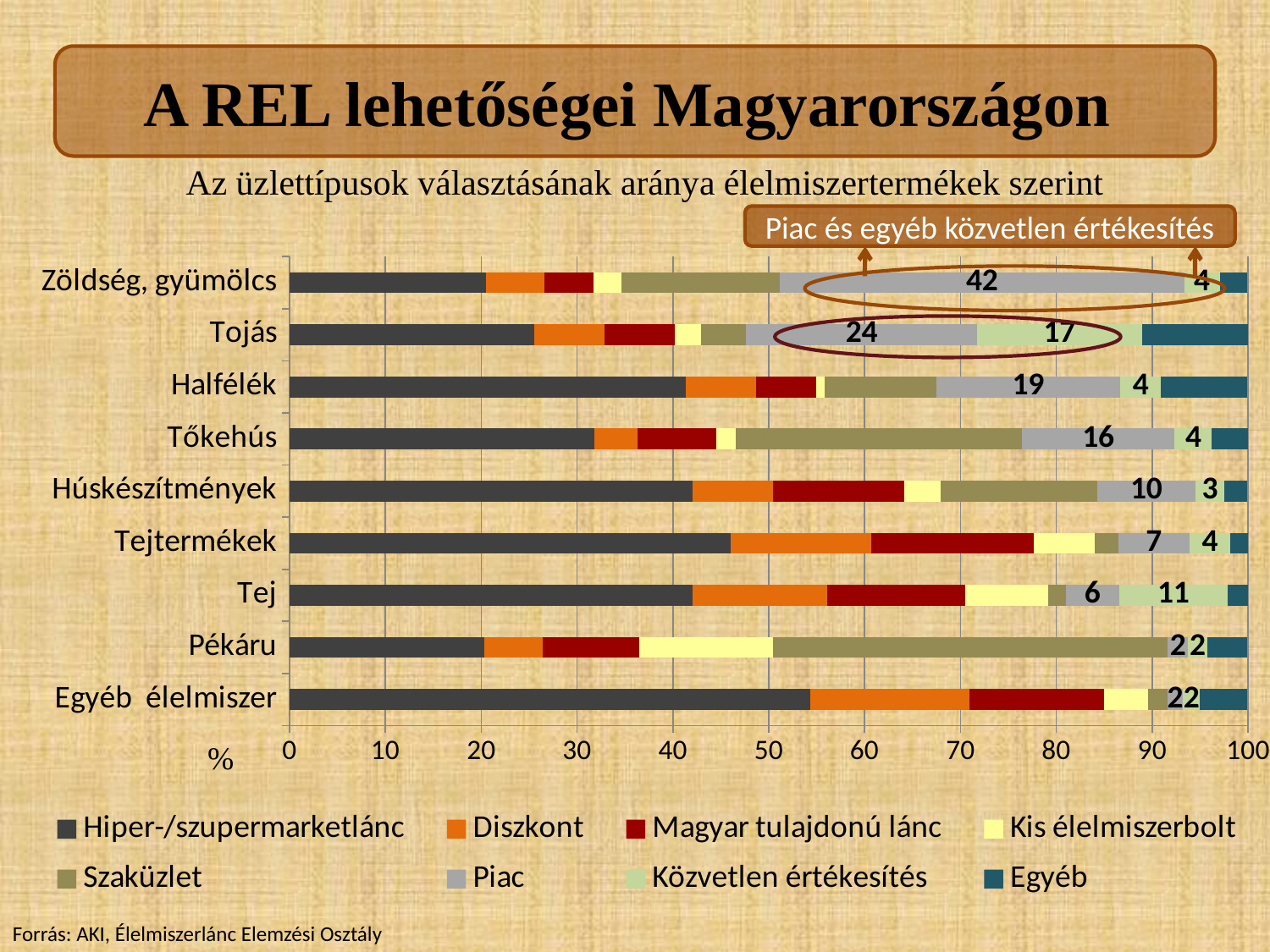
What is the difference between the Piac values for Zöldség, gyümölcs and Tojás? 18 How many series does the legend list? 8 What is the combined Piac and Közvetlen értékesítés value for Tojás? 41 What is the Piac value for Halfélék? 19 How many food product categories are listed on the vertical axis? 9 What kind of chart is shown on the slide? stacked bar chart Is the Hiper-/szupermarketlánc value for Egyéb élelmiszer greater or less than 50? greater Which category has the highest Közvetlen értékesítés value? Tojás Which is larger: the Közvetlen értékesítés value for Tojás or for Tej? Tojás What is the Piac value for Zöldség, gyümölcs? 42 What is the Közvetlen értékesítés value for Tojás? 17 Which category has the highest Piac value? Zöldség, gyümölcs